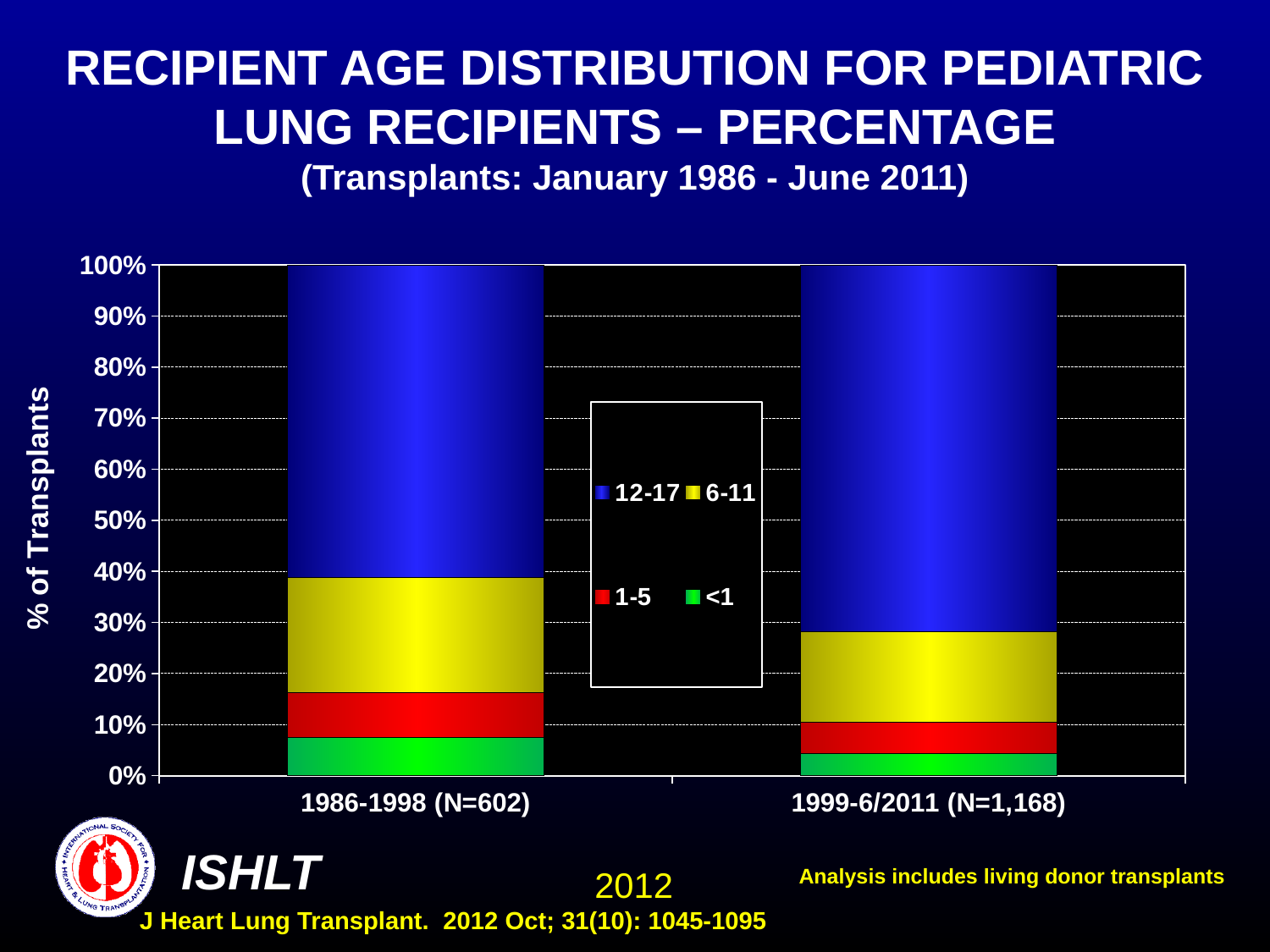
Which period has the larger share of 12-17 year old recipients, 1986-1998 or 1999-6/2011? 1999-6/2011 Which age group makes up the smallest share of transplants in the 1999-6/2011 period? <1 What kind of chart is shown on the slide? Stacked bar chart Which age group makes up the largest share of transplants in the 1986-1998 period? 12-17 What is the label of the y axis? % of Transplants Is the share of <1 year old recipients in the 1986-1998 period greater or less than 10%? less How many time-period categories are shown on the x axis? 2 Which period has the larger share of <1 year old recipients, 1986-1998 or 1999-6/2011? 1986-1998 What is the number of transplants (N) for the 1999-6/2011 period? N=1,168 Is the share of 12-17 year old recipients in the 1999-6/2011 period greater or less than 60%? greater Is the share of 12-17 year old recipients in the 1986-1998 period greater or less than 50%? greater How many age groups does the legend list? 4